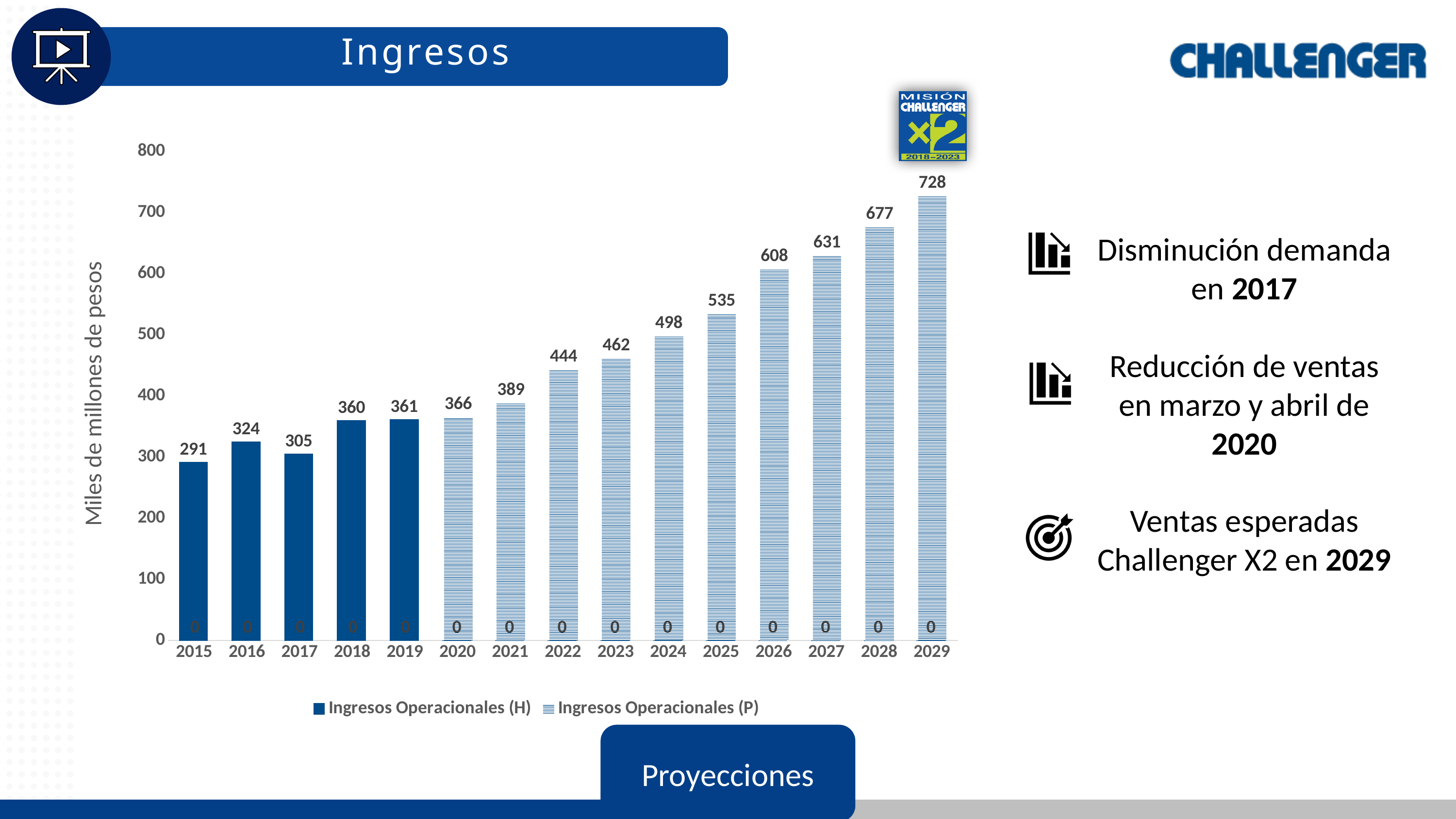
How many series does the legend of the Ingresos chart list? 2 What is the difference between the values for 2029 and 2028 in the Ingresos chart? 51 What is the value for 2015 in the Ingresos chart? 291 What is the value for 2020 in the Ingresos chart? 366 Which year has the highest value in the Ingresos chart? 2029 What kind of chart is shown on the slide? Bar chart What is the difference between the values for 2018 and 2017 in the Ingresos chart? 55 What is the y-axis label of the Ingresos chart? Miles de millones de pesos How many years are shown on the x axis of the Ingresos chart? 15 What is the projected value for 2029 in the Ingresos chart? 728 Which year has the lowest value in the Ingresos chart? 2015 Which is larger in the Ingresos chart, the value for 2016 or the value for 2017? 2016